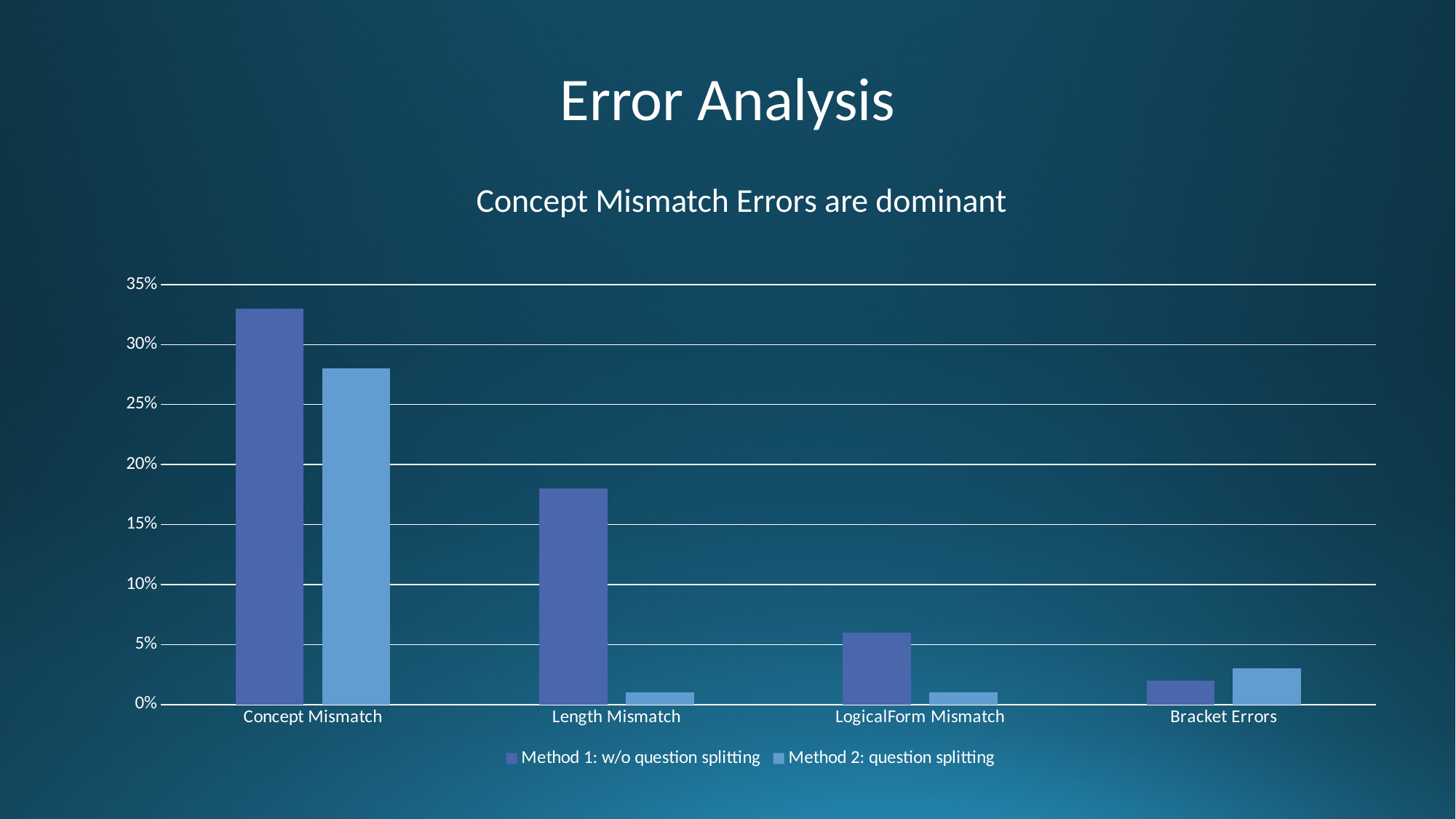
Is the value for Concept Mismatch under Method 1: w/o question splitting greater or less than 30%? greater How many series does the legend list? 2 What kind of chart is shown on the slide? bar chart Is the value for Length Mismatch under Method 1: w/o question splitting greater or less than 15%? greater How many error categories are shown on the x axis? 4 Which error category has the highest value for Method 2: question splitting? Concept Mismatch Which error category has the highest value for Method 1: w/o question splitting? Concept Mismatch Is the value for Concept Mismatch under Method 2: question splitting greater or less than 30%? less For Length Mismatch, which method has the larger value, Method 1: w/o question splitting or Method 2: question splitting? Method 1: w/o question splitting For Bracket Errors, which method has the larger value, Method 1: w/o question splitting or Method 2: question splitting? Method 2: question splitting What is the subtitle shown above the chart? Concept Mismatch Errors are dominant Which error category has the lowest value for Method 1: w/o question splitting? Bracket Errors